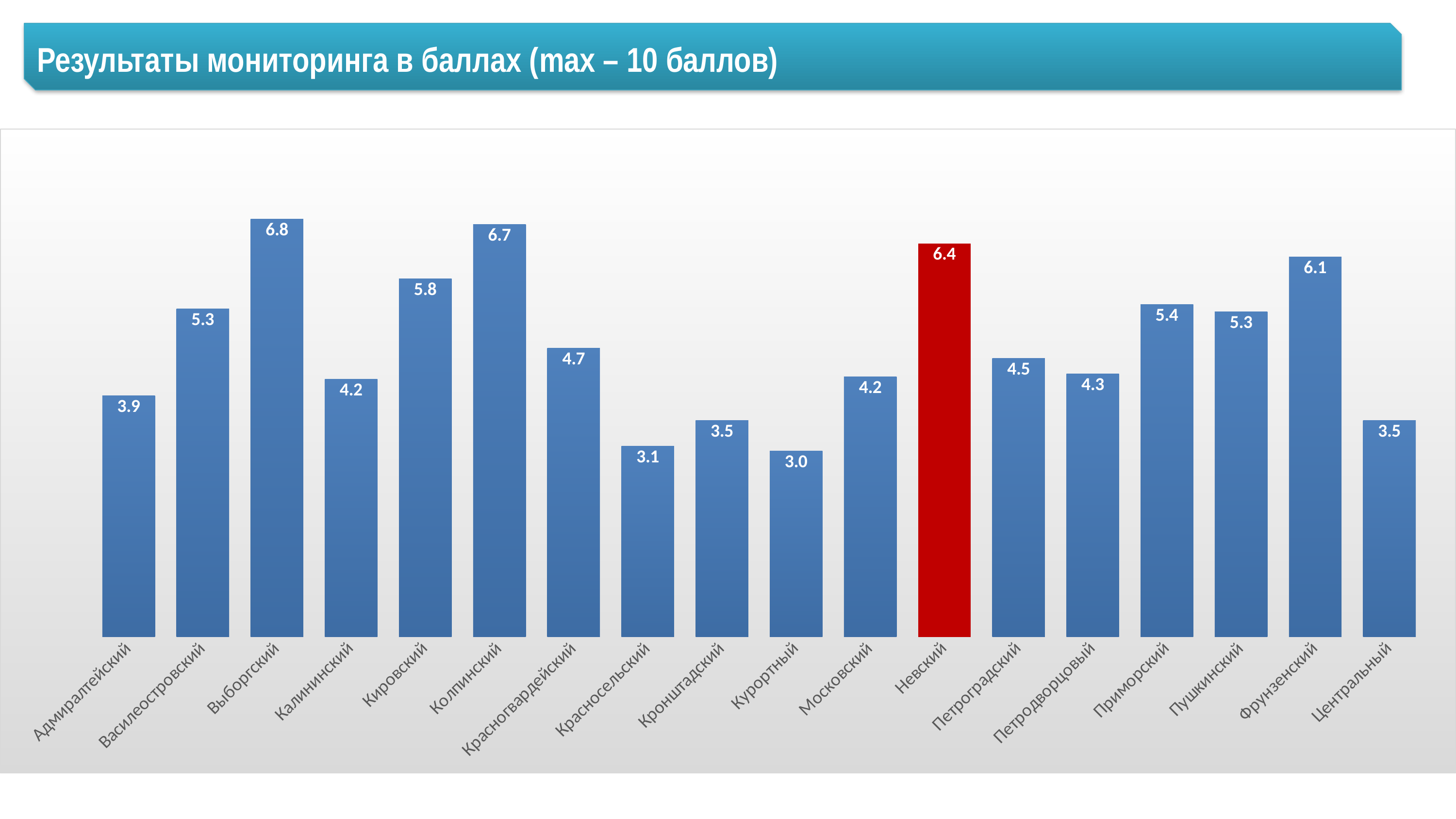
Which is larger, the value for Красносельский or the value for Петродворцовый? Петродворцовый Which district has the highest value? Выборгский How many districts are shown in the chart? 18 What is the difference between the values for Невский and Курортный? 3.4 What is the value for Невский? 6.4 What is the value for Фрунзенский? 6.1 Which is larger, the value for Кировский or the value for Приморский? Кировский Which district has the lowest value? Курортный What kind of chart is shown on the slide? Bar chart What is the difference between the values for Выборгский and Колпинский? 0.1 What is the value for Адмиралтейский? 3.9 Which district's bar is coloured red instead of blue? Невский